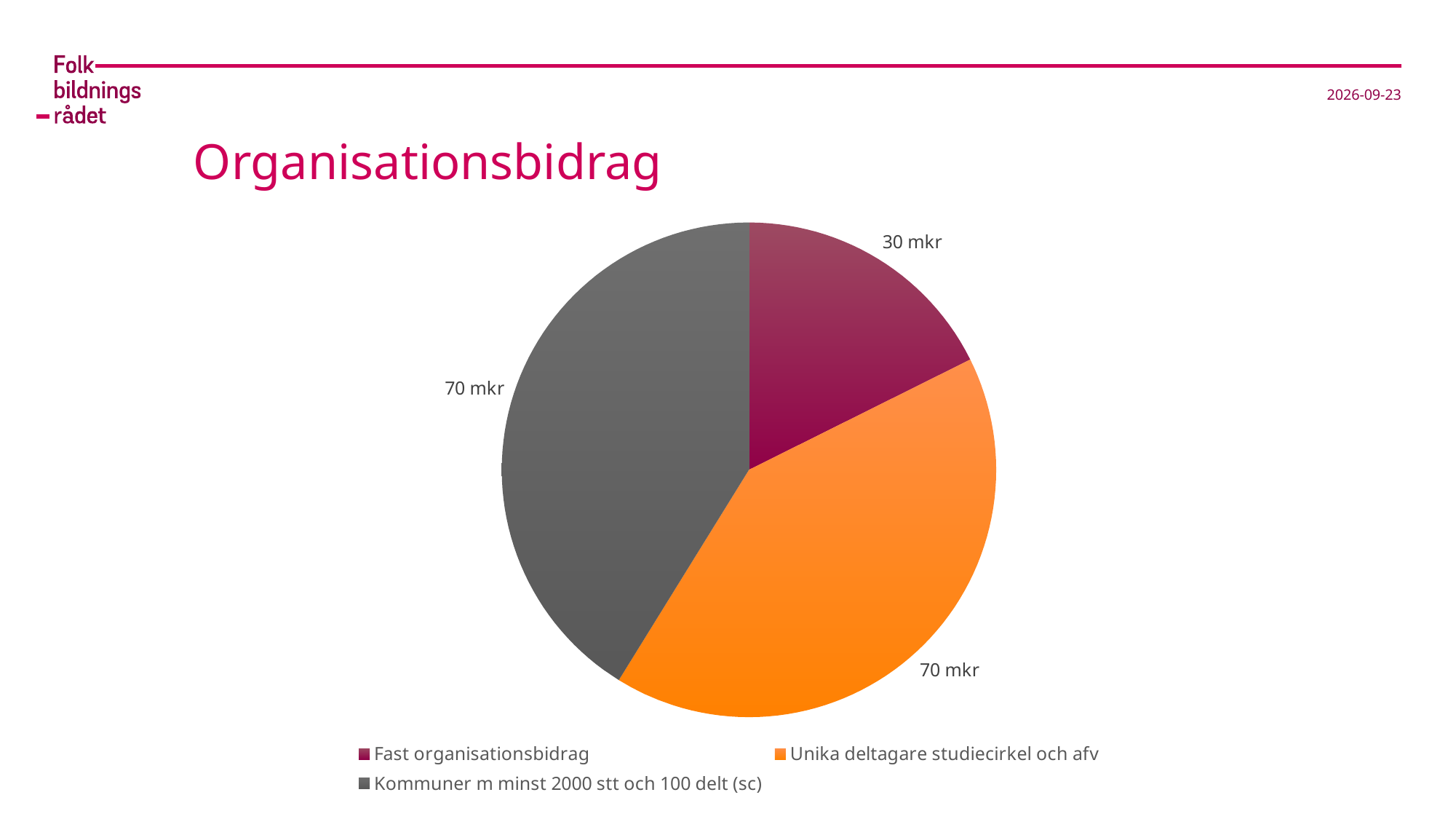
Which colour represents Unika deltagare studiecirkel och afv in the chart? Orange What is the value for Kommuner m minst 2000 stt och 100 delt (sc)? 70 mkr Which category has the smallest slice of the pie? Fast organisationsbidrag What is the total of all slices in the pie chart? 170 mkr What is the difference between Kommuner m minst 2000 stt och 100 delt (sc) and Fast organisationsbidrag? 40 mkr What is the value for Fast organisationsbidrag? 30 mkr Which is larger, Fast organisationsbidrag or Unika deltagare studiecirkel och afv? Unika deltagare studiecirkel och afv What is the value for Unika deltagare studiecirkel och afv? 70 mkr What kind of chart is shown on the slide? Pie chart How many slices does the pie chart have? 3 What is the title of the chart? Organisationsbidrag How many entries does the legend list? 3